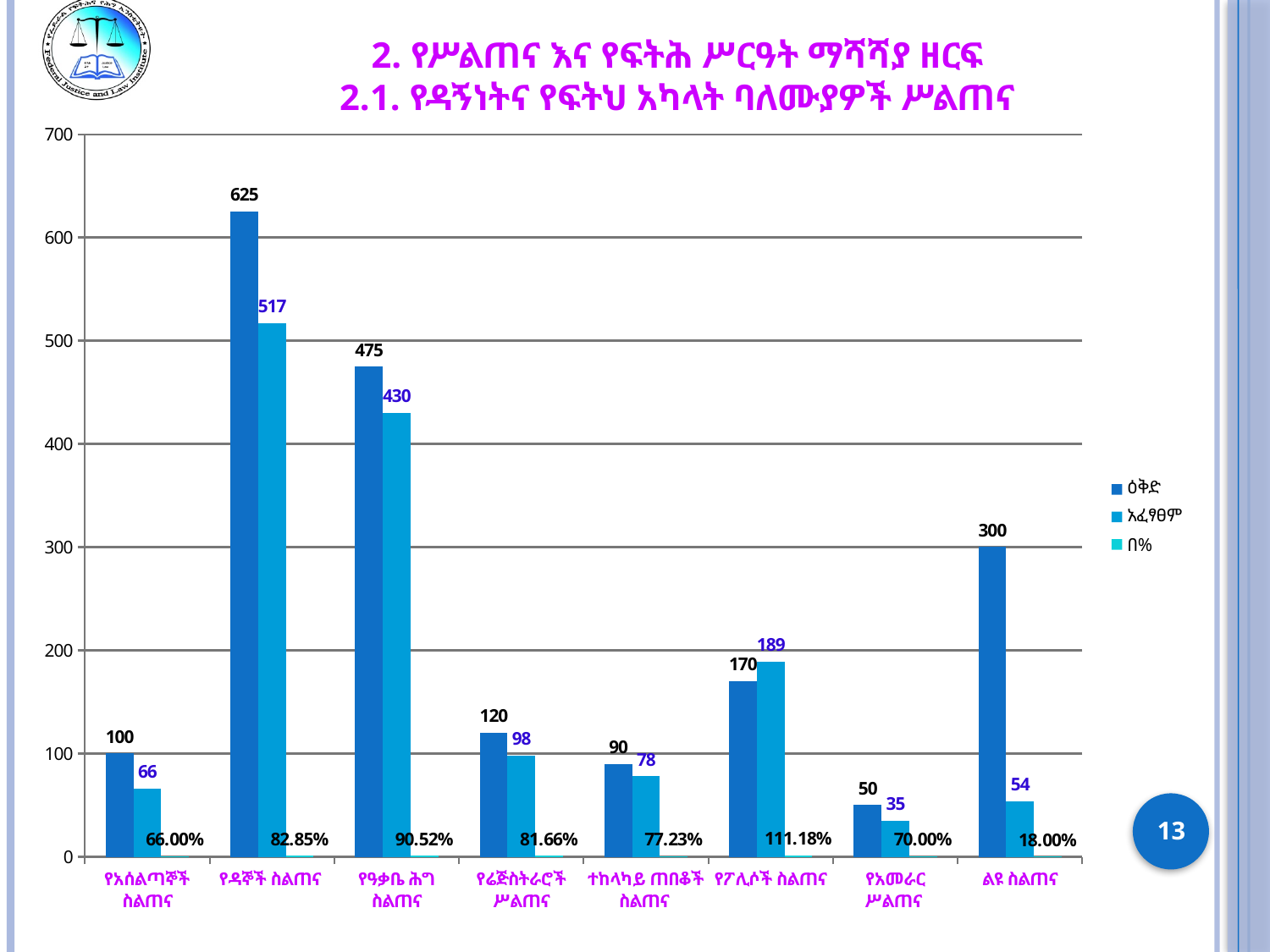
What percentage (በ%) is shown for የፖሊሶች ስልጠና? 111.18% Which category has the lowest ዕቅድ value? የአመራር ሥልጠና How many series does the legend list? 3 How many categories are shown on the x axis? 8 What is the ዕቅድ value for የዳኞች ስልጠና? 625 Which category has the highest ዕቅድ value? የዳኞች ስልጠና Which is larger for የፖሊሶች ስልጠና, the ዕቅድ value or the አፈፃፀም value? አፈፃፀም What is the አፈፃፀም value for ልዩ ስልጠና? 54 What kind of chart is shown on the slide? Bar chart What is the difference between the ዕቅድ and አፈፃፀም values for የዳኞች ስልጠና? 108 What is the አፈፃፀም value for የዓቃቤ ሕግ ስልጠና? 430 Which category has the lowest በ% value? ልዩ ስልጠና